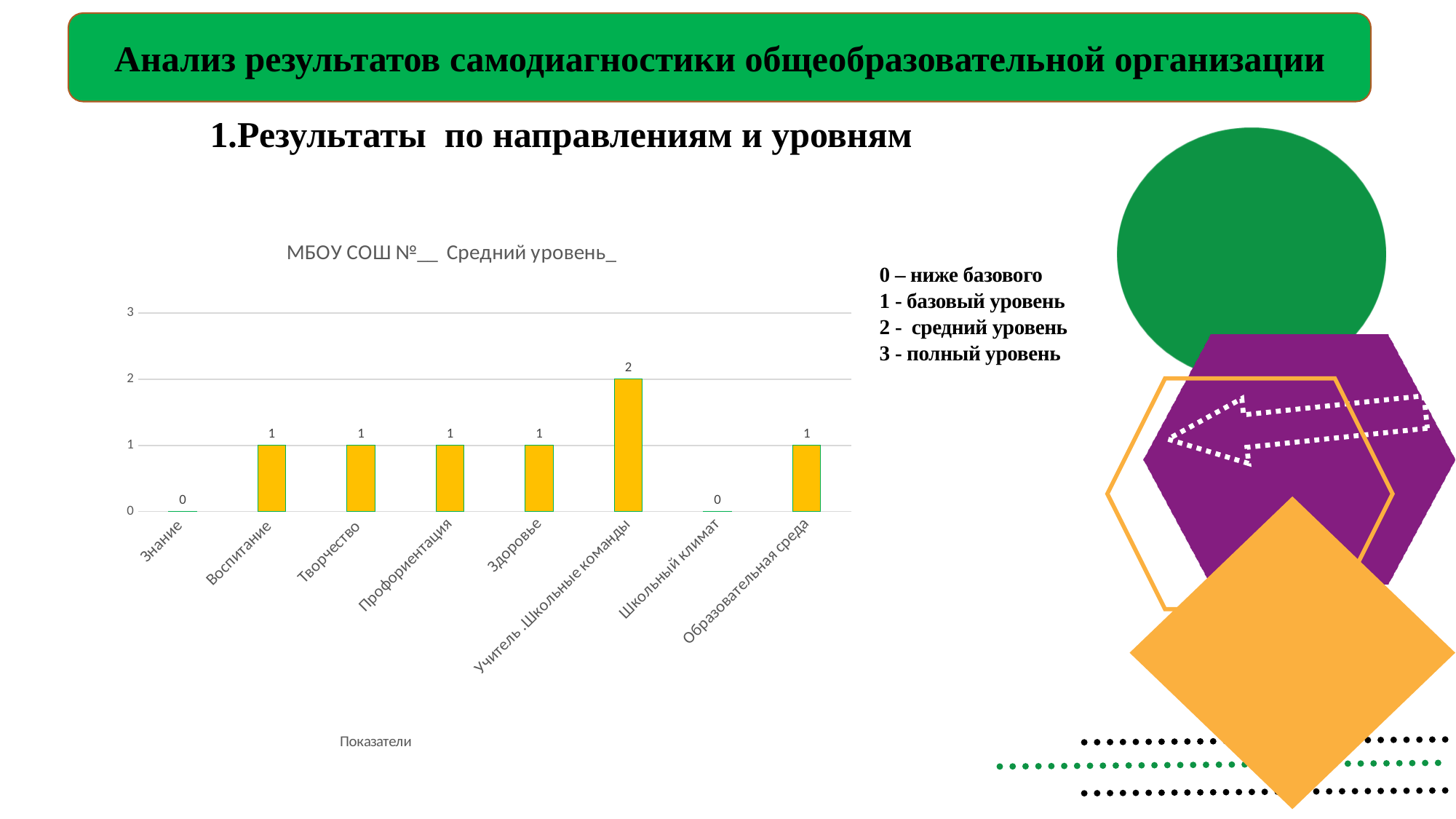
What kind of chart is shown on the slide? bar chart What is the value for Воспитание? 1 Is the value for Учитель. Школьные команды greater or less than 1? greater What is the value for Школьный климат? 0 What is the value for Учитель. Школьные команды? 2 How many categories are shown on the x axis? 8 How many categories have a value of 0? 2 Which is larger, the value for Творчество or the value for Знание? Творчество What is the difference between the values for Учитель. Школьные команды and Здоровье? 1 What is the label of the x axis? Показатели What is the value for Образовательная среда? 1 Which category has the highest value? Учитель. Школьные команды